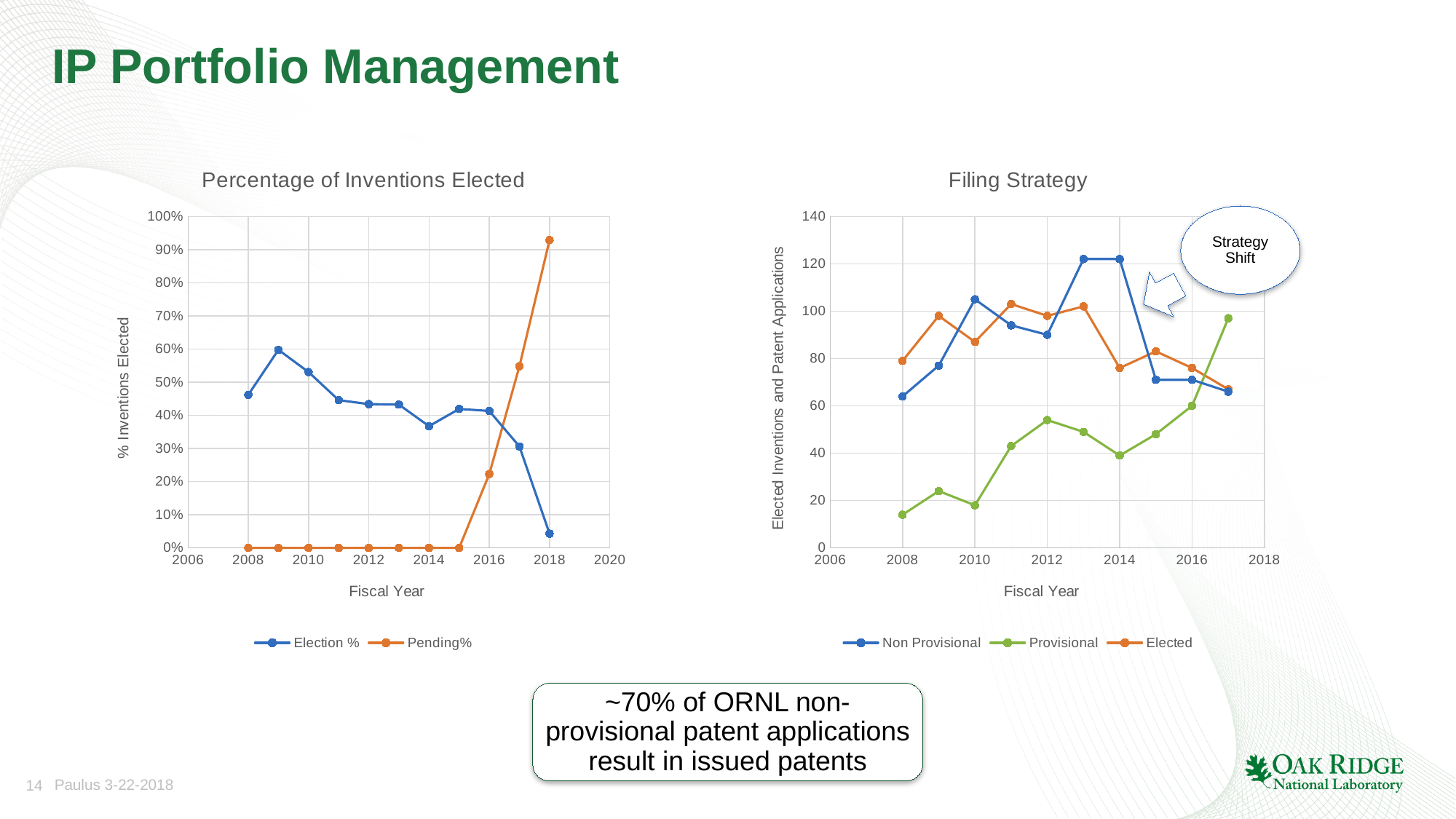
In the 'Filing Strategy' chart, in which fiscal year is the Provisional series lowest? 2008 How many fiscal years are plotted for each series in the 'Filing Strategy' chart? 10 How many series does the legend of the 'Filing Strategy' chart list? 3 In the 'Percentage of Inventions Elected' chart, is the Pending% value for 2018 greater or less than 90%? greater What kind of chart is the 'Percentage of Inventions Elected' chart? line chart In the 'Filing Strategy' chart, which series has the larger value in 2017, Provisional or Non Provisional? Provisional In the 'Percentage of Inventions Elected' chart, is the Election % value for 2018 greater or less than 10%? less In the 'Filing Strategy' chart, is the Non Provisional value for 2010 greater or less than 100? greater In the 'Percentage of Inventions Elected' chart, what is the Pending% value for 2010? 0% In the 'Percentage of Inventions Elected' chart, which series has the larger value in 2017, Election % or Pending%? Pending% In the 'Percentage of Inventions Elected' chart, in which fiscal year is Election % highest? 2009 In the 'Percentage of Inventions Elected' chart, does Pending% rise or fall from 2015 to 2018? rise